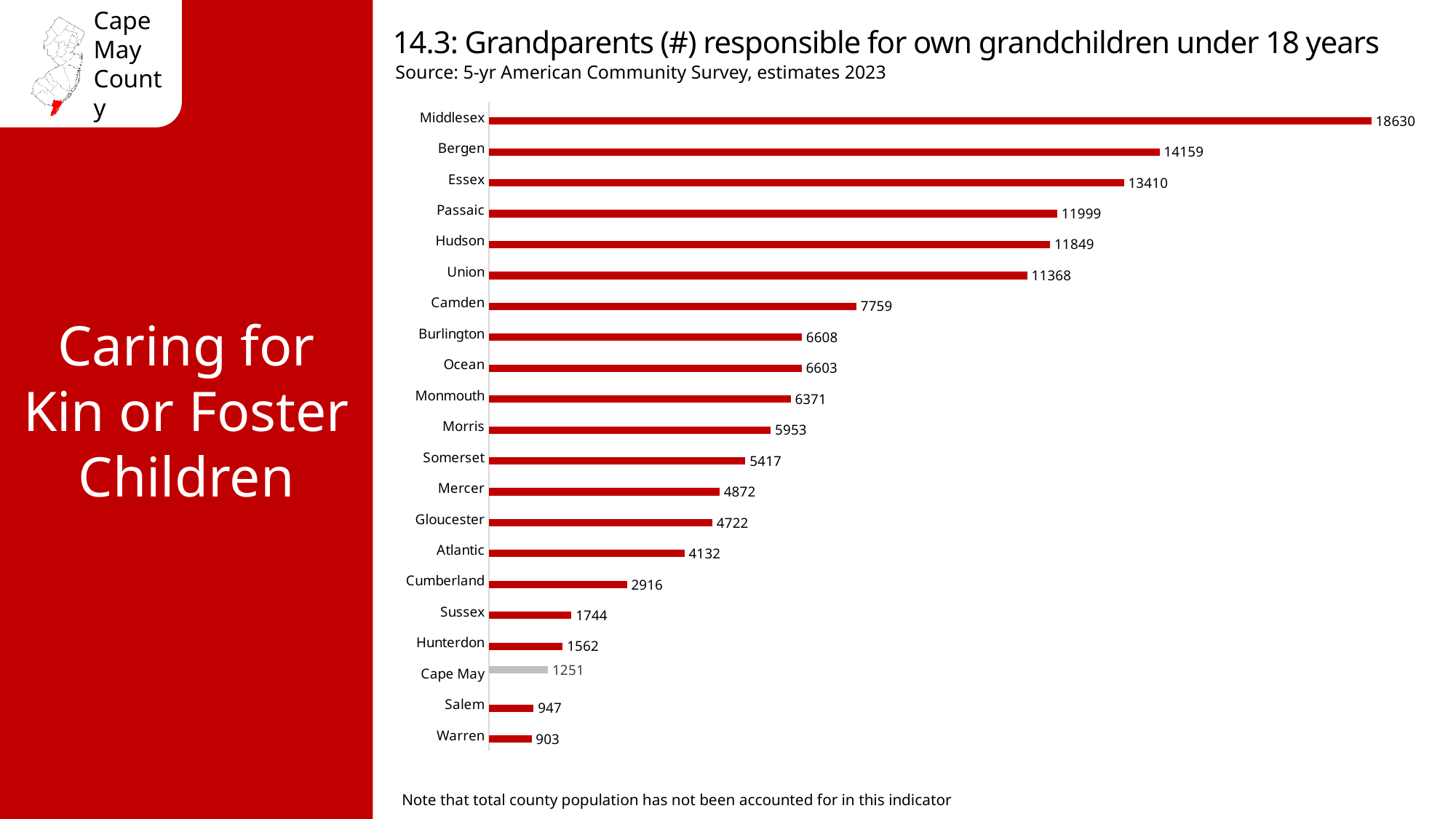
What is the value for Atlantic? 4132 What is the difference between the values for Middlesex and Bergen? 4471 Which county has the lowest value? Warren Which county's bar is coloured grey instead of red? Cape May What is the value for Cape May? 1251 What is the difference between the values for Cape May and Salem? 304 What kind of chart is shown on the slide? Bar chart How many counties are shown in the chart? 21 Which has a larger value, Sussex or Hunterdon? Sussex Which county has the highest value? Middlesex What is the value for Camden? 7759 Which has a larger value, Passaic or Union? Passaic